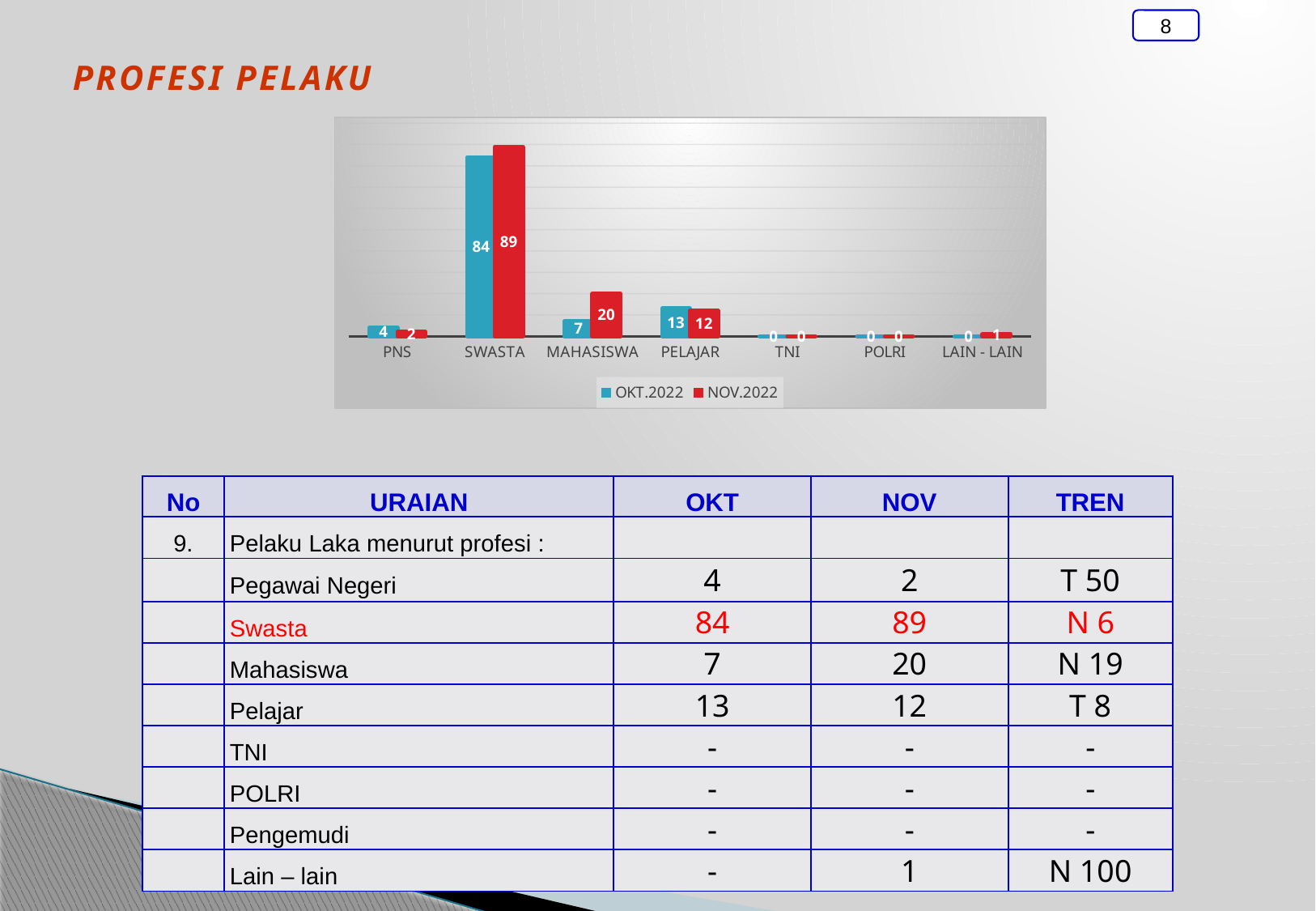
What kind of chart is shown on the slide? bar chart What is the value for MAHASISWA in the NOV.2022 series? 20 How many series does the chart legend list? 2 What is the value for PELAJAR in the OKT.2022 series? 13 How many categories are shown on the x axis of the chart? 7 What is the difference between the NOV.2022 and OKT.2022 values for MAHASISWA? 13 Which category has the highest value in the NOV.2022 series? SWASTA Which is larger for PELAJAR, the OKT.2022 value or the NOV.2022 value? OKT.2022 What is the difference between the NOV.2022 and OKT.2022 values for SWASTA? 5 What is the value for LAIN - LAIN in the NOV.2022 series? 1 What is the value for SWASTA in the OKT.2022 series? 84 What is the value for PNS in the NOV.2022 series? 2